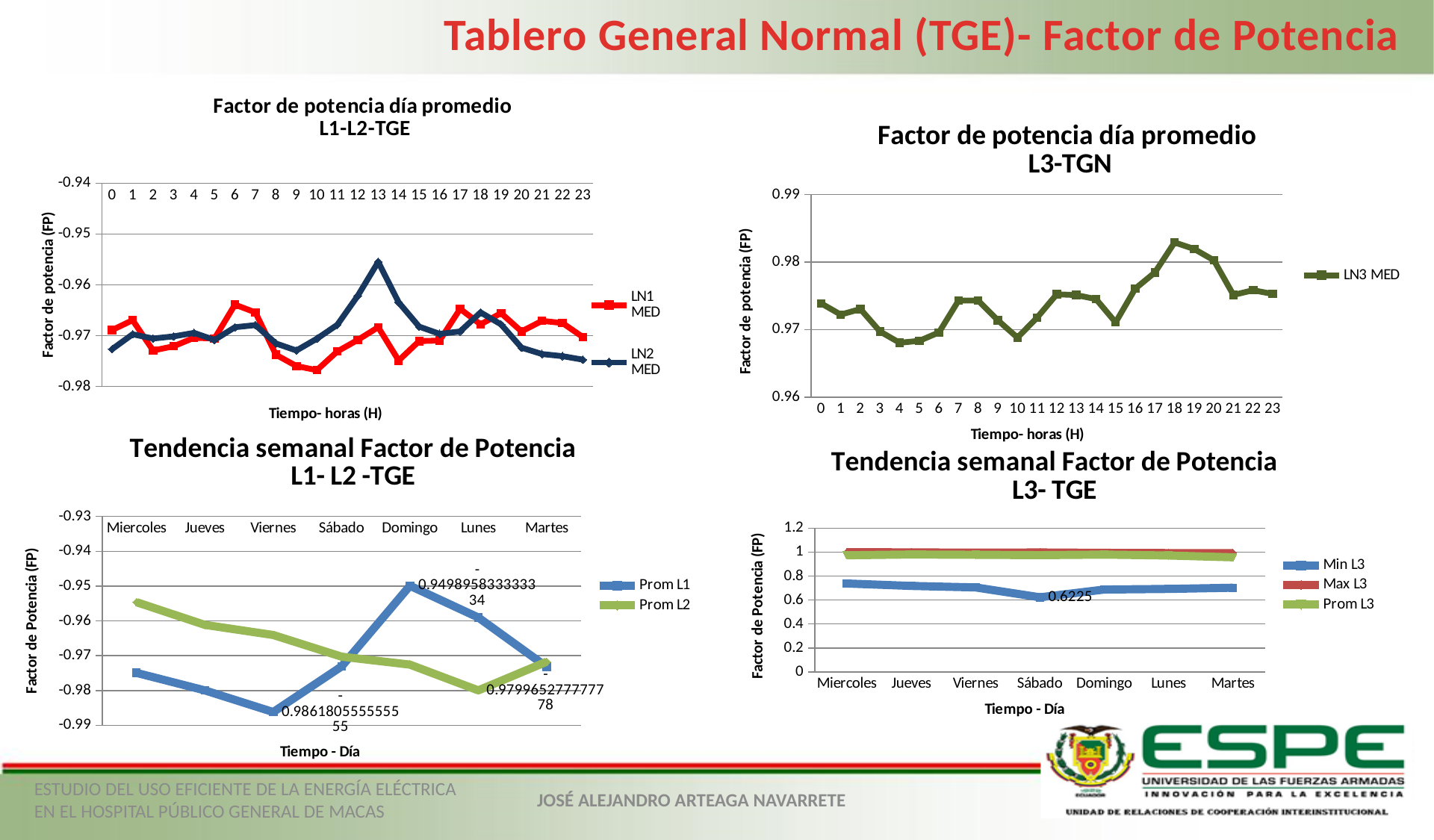
In the top-right chart 'Factor de potencia día promedio L3-TGN', is the LN3 MED value at hour 18 greater or less than 0.98? greater In the bottom-right chart 'Tendencia semanal Factor de Potencia L3- TGE', which series has the highest value on Miercoles? Max L3 How many series does the legend of the top-left chart 'Factor de potencia día promedio L1-L2-TGE' list? 2 In the top-right chart 'Factor de potencia día promedio L3-TGN', at which hour does LN3 MED reach its highest value? 18 In the top-left chart 'Factor de potencia día promedio L1-L2-TGE', which series has the higher value at hour 13, LN1 MED or LN2 MED? LN2 MED In the bottom-left chart 'Tendencia semanal Factor de Potencia L1- L2 -TGE', what is the Prom L1 value on Viernes? -0.986180555555555 In the bottom-left chart 'Tendencia semanal Factor de Potencia L1- L2 -TGE', on which day does Prom L1 reach its highest value? Domingo What kind of chart is the top-left chart titled 'Factor de potencia día promedio L1-L2-TGE'? Line chart How many hour points are plotted along the x axis of the top-right chart 'Factor de potencia día promedio L3-TGN'? 24 What is the legend entry of the top-right chart 'Factor de potencia día promedio L3-TGN'? LN3 MED In the bottom-right chart 'Tendencia semanal Factor de Potencia L3- TGE', what is the Min L3 value on Sábado? 0.6225 How many series does the legend of the bottom-right chart 'Tendencia semanal Factor de Potencia L3- TGE' list? 3